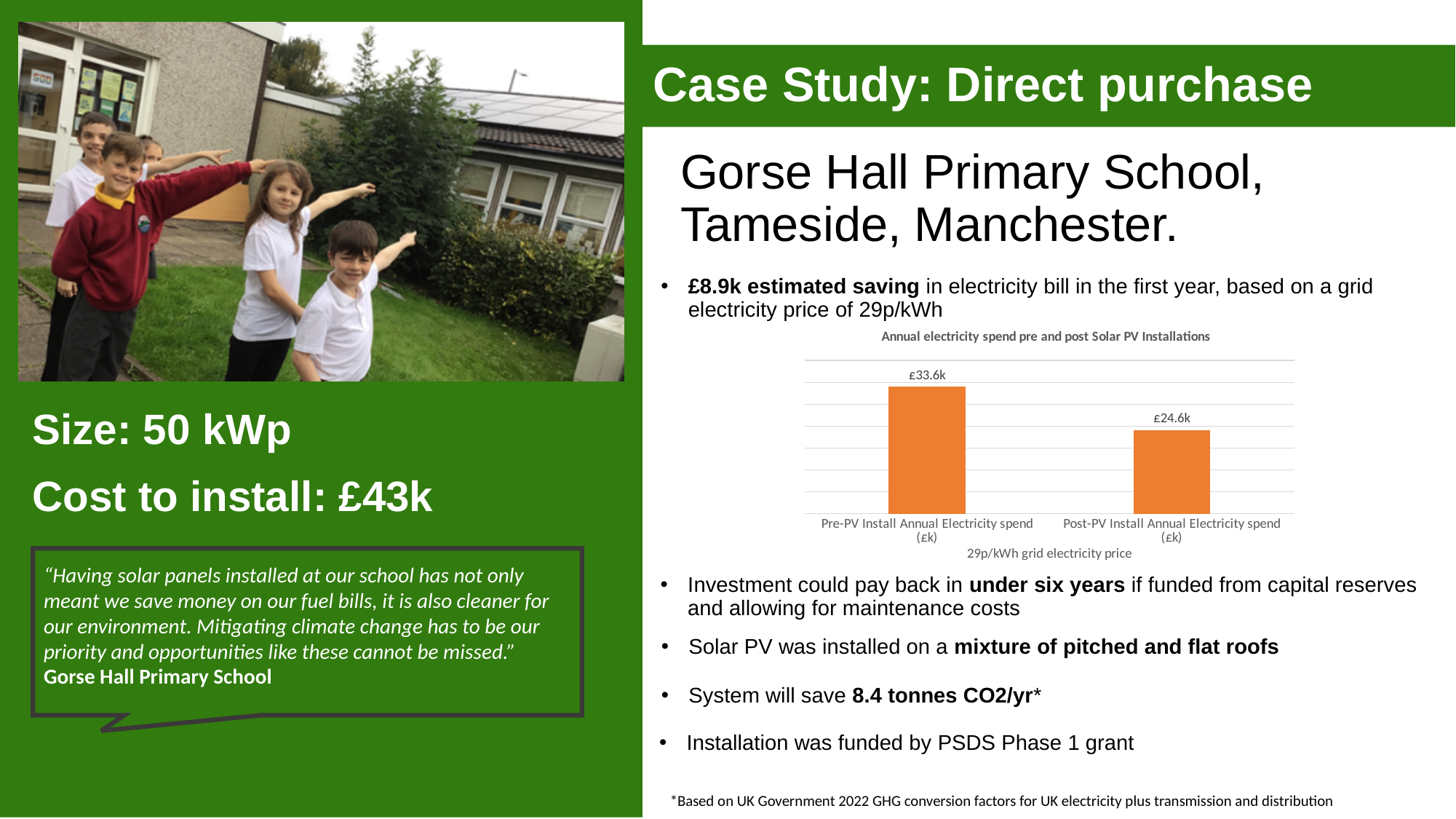
How many bars are plotted on the chart? 2 What is the title of the chart? Annual electricity spend pre and post Solar PV Installations What is the Pre-PV Install Annual Electricity spend shown on the chart? £33.6k What is the Post-PV Install Annual Electricity spend shown on the chart? £24.6k What type of chart is shown on the slide? bar chart Is the Pre-PV Install spend larger or smaller than the Post-PV Install spend? larger Which category has the higher annual electricity spend on the chart? Pre-PV Install Annual Electricity spend (£k) Which category has the lower annual electricity spend on the chart? Post-PV Install Annual Electricity spend (£k) What grid electricity price is stated in the chart's x-axis title? 29p/kWh grid electricity price Do the values rise or fall from left to right across the chart? fall By how much does the annual electricity spend fall from Pre-PV Install to Post-PV Install according to the chart's data labels? £9k